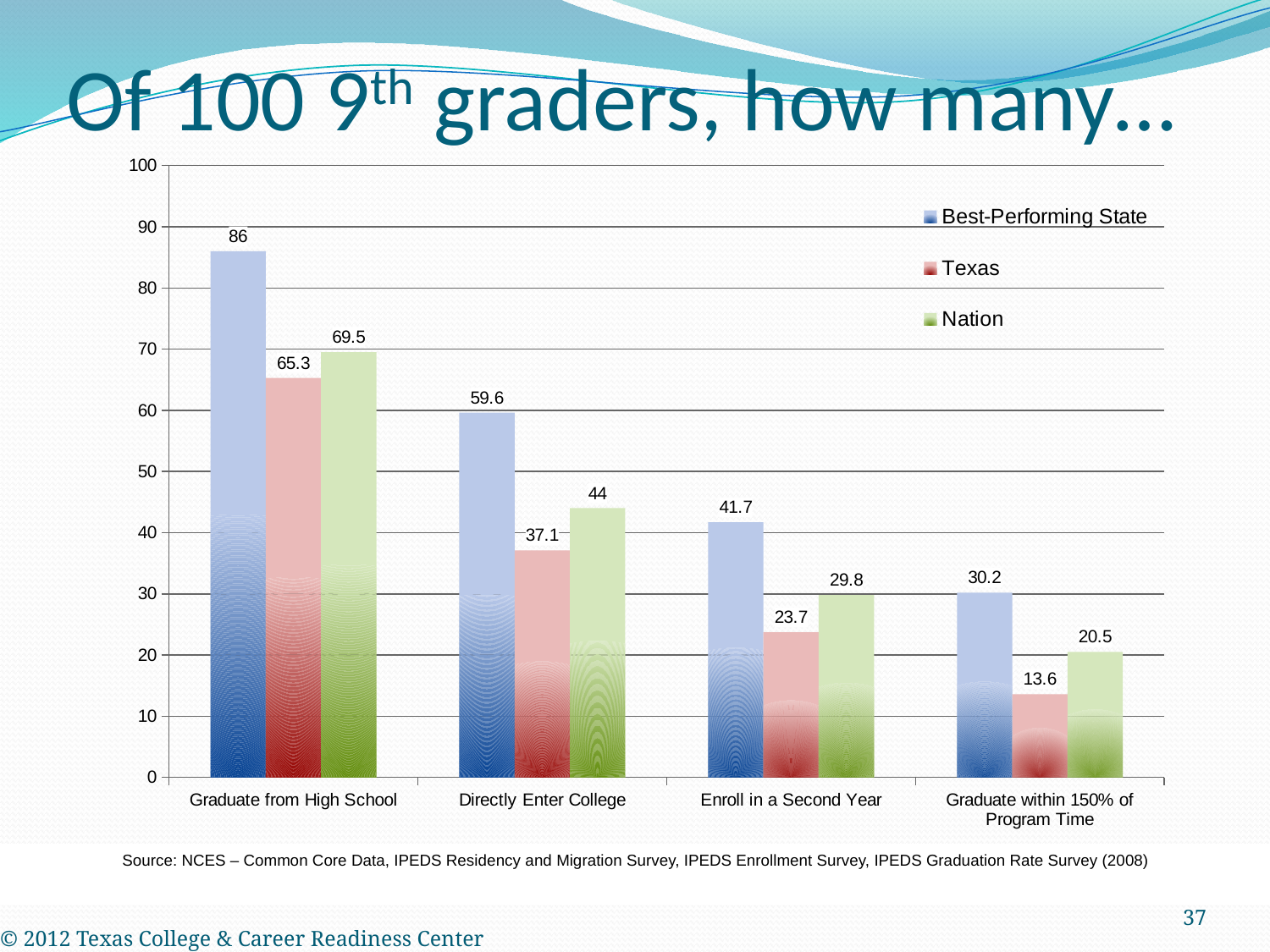
What is the value for Texas in the Graduate from High School category? 65.3 Which category has the lowest value for Texas? Graduate within 150% of Program Time What is the difference between the Best-Performing State and Texas values in the Directly Enter College category? 22.5 What kind of chart is shown on the slide? Bar chart What is the value for the Nation in the Directly Enter College category? 44 How many categories are shown on the x axis? 4 What is the value for the Best-Performing State in the Enroll in a Second Year category? 41.7 Which is larger in the Enroll in a Second Year category: the Texas value or the Nation value? Nation What colour represents Texas in the chart? Red Which series has the highest value in the Graduate from High School category? Best-Performing State How many series does the legend list? 3 Do the Best-Performing State values rise or fall from left to right across the categories? Fall